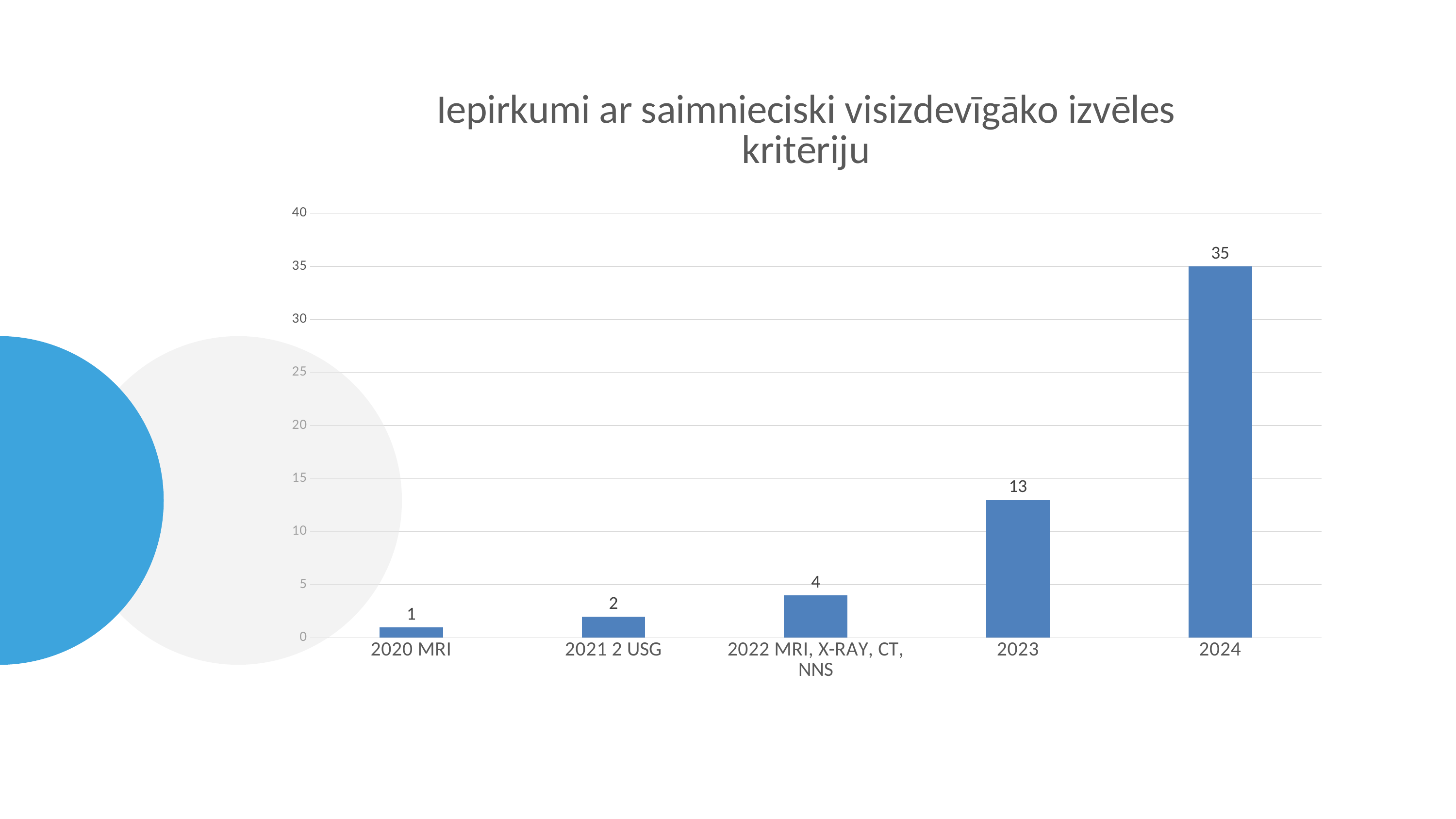
Which is larger, the value for 2021 2 USG or the value for 2022 MRI, X-RAY, CT, NNS? 2022 MRI, X-RAY, CT, NNS What is the value for 2022 MRI, X-RAY, CT, NNS? 4 What is the value for 2023? 13 Which category has the lowest value? 2020 MRI Do the values rise or fall from left to right along the x axis? rise What is the value for 2024? 35 Is the value for 2023 greater or less than 10? greater What is the value for 2020 MRI? 1 Which category has the highest value? 2024 What is the difference between the values for 2024 and 2023? 22 How many categories are shown on the x axis? 5 What kind of chart is shown on the slide? bar chart